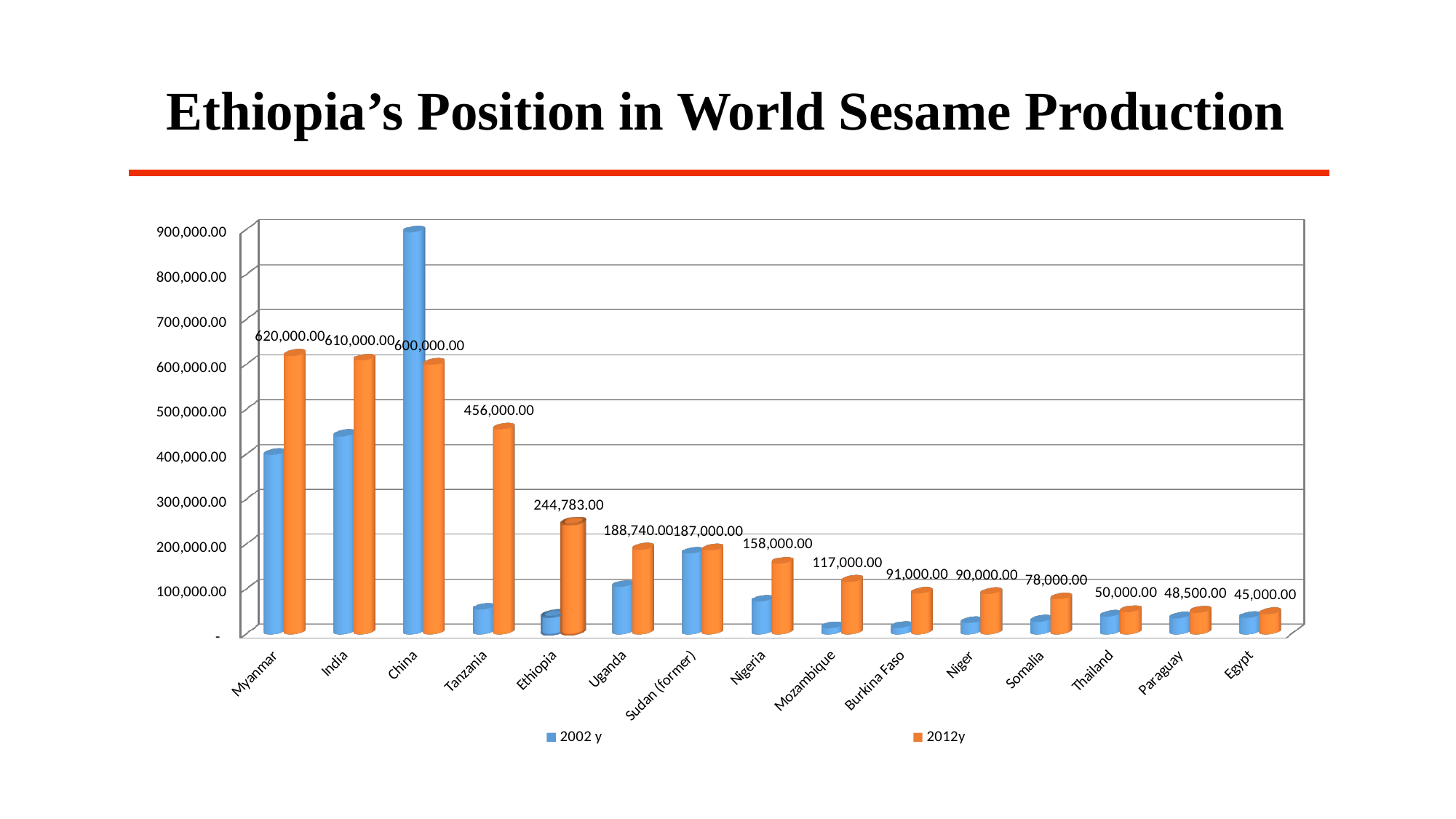
What is the difference between the 2012y values for Myanmar and India? 10,000.00 What kind of chart is shown on the slide? bar chart Which has the larger 2012y value, Uganda or Sudan (former)? Uganda What is the 2012y value for Tanzania? 456,000.00 What is the 2012y value for Paraguay? 48,500.00 What is the difference between the 2012y values for Ethiopia and Nigeria? 86,783.00 Which country has the highest 2012y value? Myanmar How many countries are shown on the x axis? 15 How many series does the legend list? 2 Which country has the lowest 2012y value? Egypt Is the 2002 y value for China greater or less than 800,000.00? greater What is the 2012y value for Ethiopia? 244,783.00